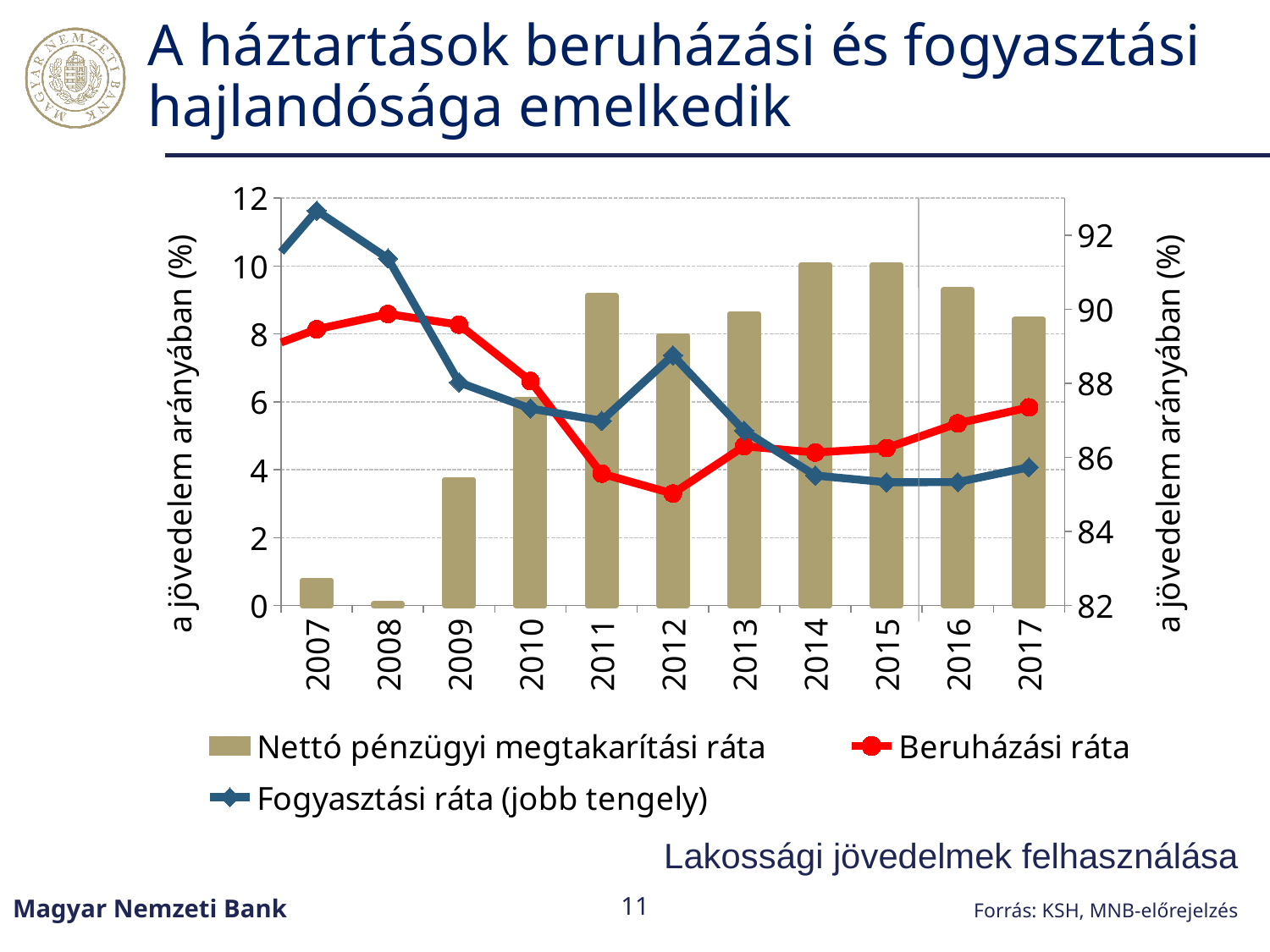
Which is larger, the Nettó pénzügyi megtakarítási ráta bar for 2011 or for 2012? 2011 How many years are shown on the x axis? 11 Is the Nettó pénzügyi megtakarítási ráta bar for 2007 greater or less than 2? less Does the Fogyasztási ráta (jobb tengely) rise or fall from 2007 to 2011? fall Is the Fogyasztási ráta (jobb tengely) for 2015 greater or less than 86? less Is the Nettó pénzügyi megtakarítási ráta bar for 2011 greater or less than 8? greater What kind of chart is shown on the slide? A combined bar and line chart In which year does the Fogyasztási ráta (jobb tengely) reach its highest value? 2007 In which year is the Beruházási ráta at its lowest? 2012 In which year is the Nettó pénzügyi megtakarítási ráta bar the lowest? 2008 How many series does the legend list? 3